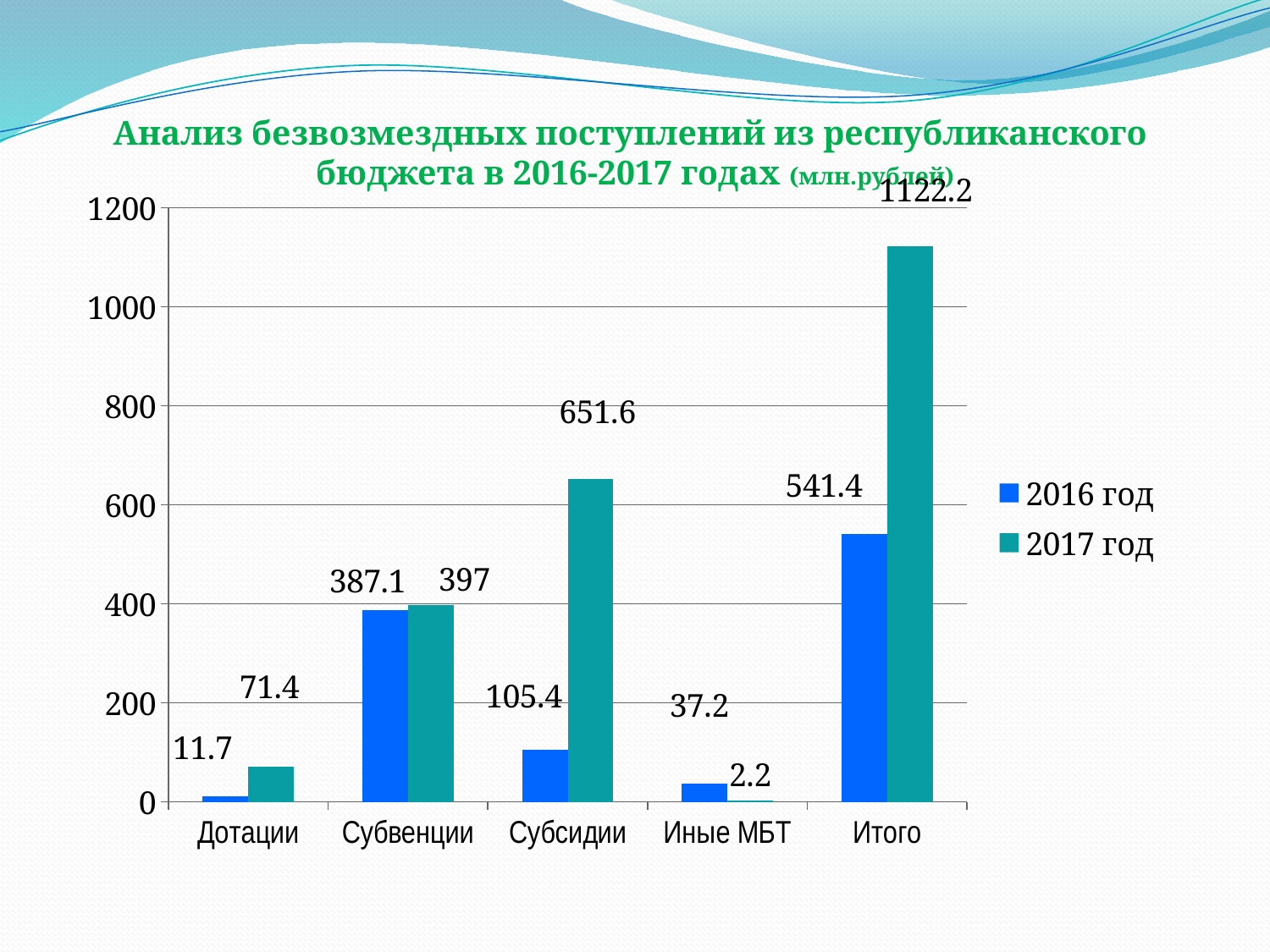
What is the value for Субсидии in the 2017 год series? 651.6 Which category has the lowest value in the 2016 год series? Дотации What unit is given in the chart title? млн.рублей How many categories are shown on the x axis? 5 What is the value for Итого in the 2016 год series? 541.4 What is the value for Дотации in the 2016 год series? 11.7 What kind of chart is shown on the slide? Bar chart What is the value for Иные МБТ in the 2017 год series? 2.2 Which is larger for Иные МБТ: the 2016 год value or the 2017 год value? 2016 год How many series does the legend list? 2 What is the difference between the 2017 год and 2016 год values for Субсидии? 546.2 Which category has the highest value in the 2017 год series? Итого